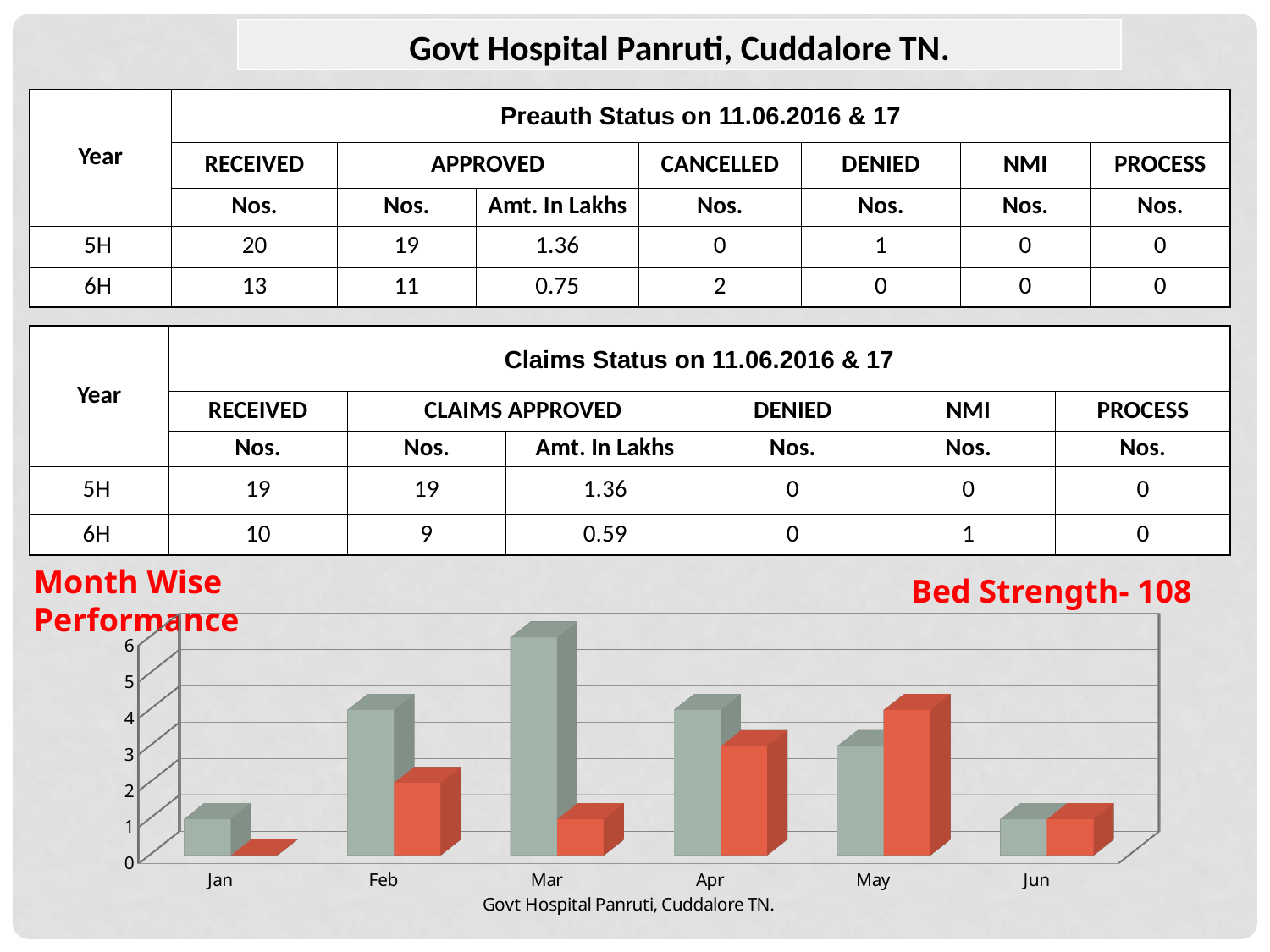
What text appears below the x axis of the Month Wise Performance chart? Govt Hospital Panruti, Cuddalore TN. In the Month Wise Performance chart, is the red bar for Jan greater or less than 1? less In the Month Wise Performance chart, for Feb, is the grey bar or the red bar taller? grey bar In the Month Wise Performance chart, which month has the tallest red bar? May In the Month Wise Performance chart, do the grey bars rise or fall from Mar to Jun? fall In the Month Wise Performance chart, is the red bar for Apr greater or less than 2? greater In the Month Wise Performance chart, is the grey bar for Mar greater or less than 5? greater What kind of chart is shown under the heading 'Month Wise Performance'? bar chart In the Month Wise Performance chart, for May, is the grey bar or the red bar taller? red bar In the Month Wise Performance chart, which month has the shortest red bar? Jan How many months are shown on the x axis of the Month Wise Performance chart? 6 In the Month Wise Performance chart, which month has the tallest grey bar? Mar